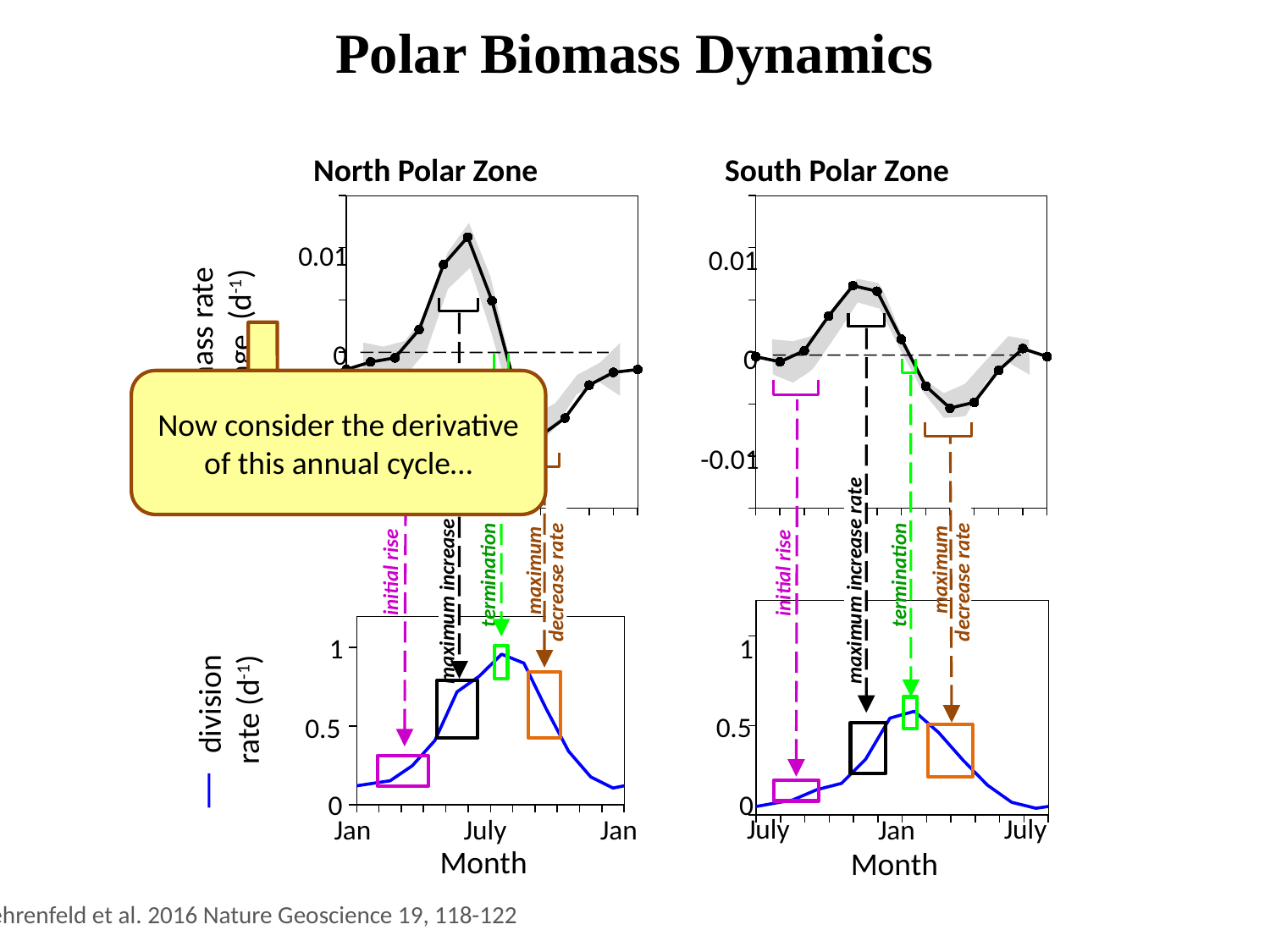
Which bottom chart shows the higher peak division rate, North Polar Zone or South Polar Zone? North Polar Zone What is the x-axis label of the bottom charts? Month How many annotated phases (initial rise, maximum increase rate, termination, maximum decrease rate) are marked on each zone's charts? 4 In the South Polar Zone bottom chart, is the peak division rate greater or less than 1? less In the South Polar Zone top chart, is the lowest value of the black line greater or less than -0.01? greater In the South Polar Zone top chart, is the peak value of the black line greater or less than 0.01? less Which top chart shows the higher peak value of the black line, North Polar Zone or South Polar Zone? North Polar Zone What kind of chart is the North Polar Zone top chart? line chart In the North Polar Zone bottom chart, does the division rate rise or fall from Jan to July? rise What is the title of the slide? Polar Biomass Dynamics